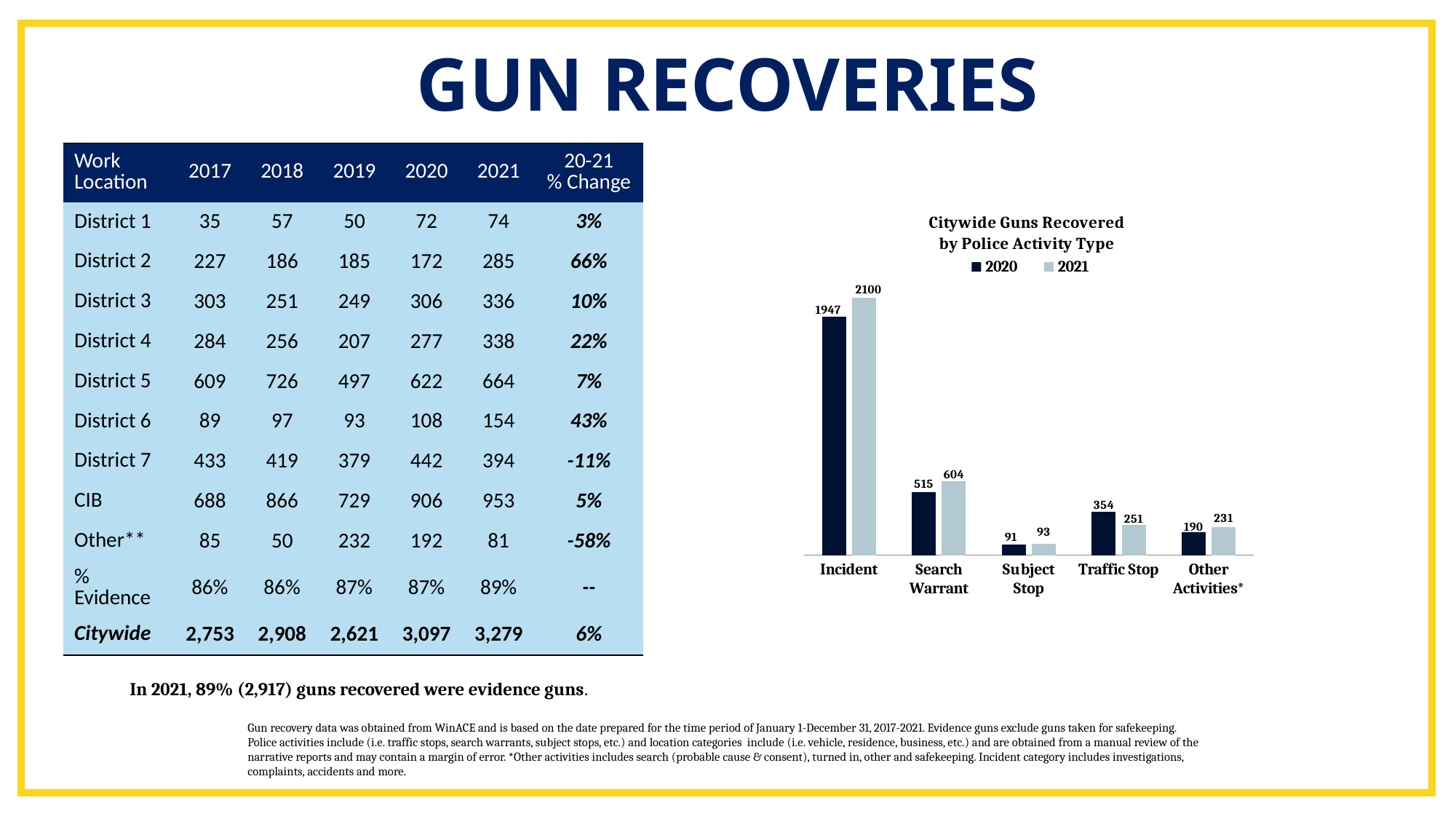
What is the difference between the 2021 and 2020 values for Other Activities* in the chart? 41 What is the 2021 value for Incident in the Citywide Guns Recovered by Police Activity Type chart? 2100 How many series does the legend of the chart list? 2 What is the 2021 value for Traffic Stop in the chart? 251 What kind of chart is the Citywide Guns Recovered by Police Activity Type chart? bar chart What is the 2020 value for Search Warrant in the chart? 515 Which police activity type has the highest number of guns recovered in 2021? Incident Which is larger for Traffic Stop in the chart: the 2020 value or the 2021 value? 2020 Which police activity type has the lowest number of guns recovered in 2020? Subject Stop What is the difference between the 2021 and 2020 values for Incident in the chart? 153 How many police activity types are shown on the x axis of the chart? 5 What is the title of the chart on the right side of the slide? Citywide Guns Recovered by Police Activity Type